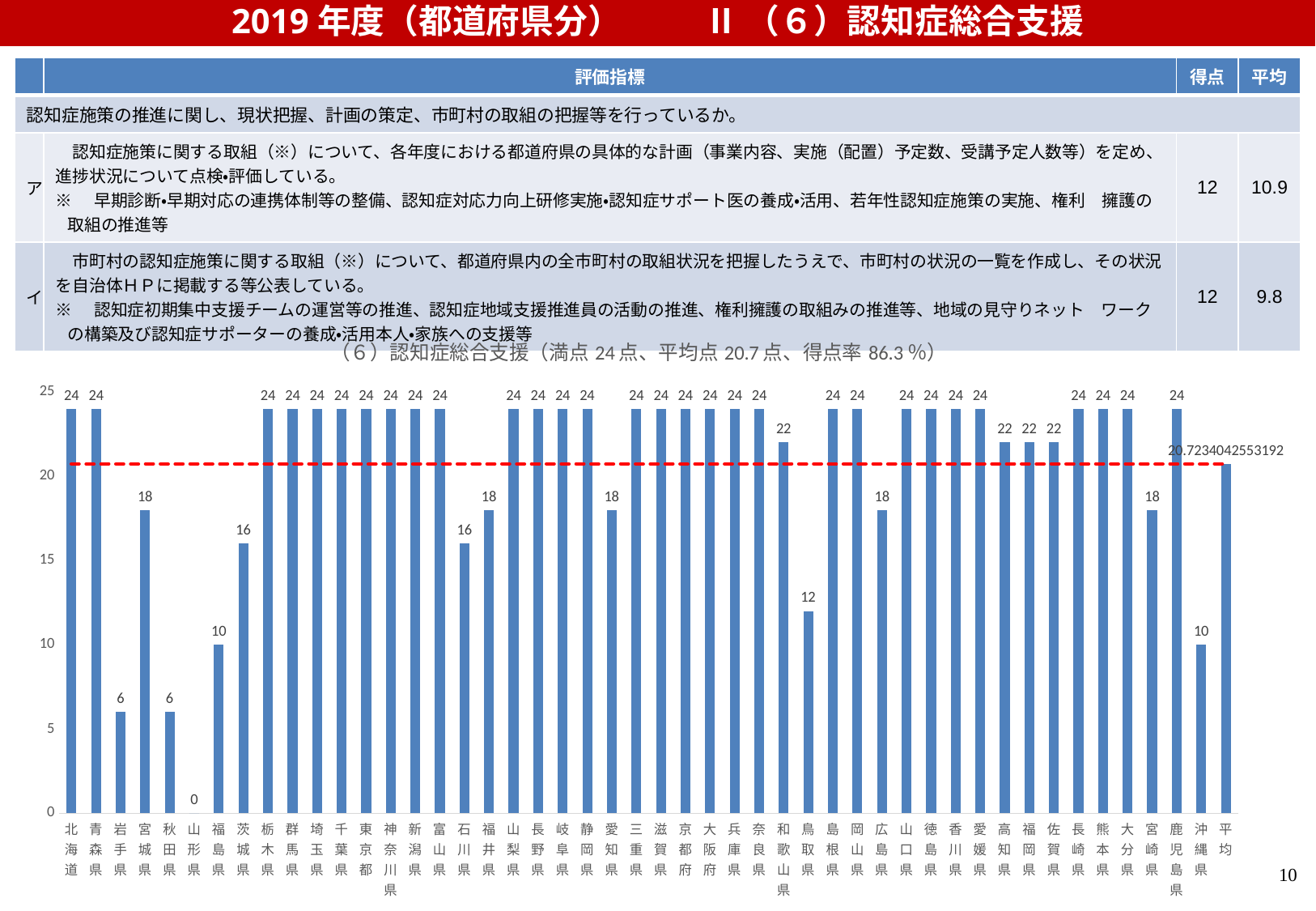
What value is printed next to the red dashed line in the chart? 20.7234042553192 Which category has the lowest value in the bar chart? 山形県 What is the value for 和歌山県 in the bar chart? 22 What is the difference between the values for 北海道 and 沖縄県? 14 Is the value for 福島県 greater or less than 15? less What is the value for 鳥取県 in the bar chart? 12 What is the value for 茨城県 in the bar chart? 16 What is the value for 山形県 in the bar chart? 0 What kind of chart is shown on the slide? bar chart Which is larger, the value for 鳥取県 or the value for 沖縄県? 鳥取県 What is the difference between the values for 宮城県 and 岩手県? 12